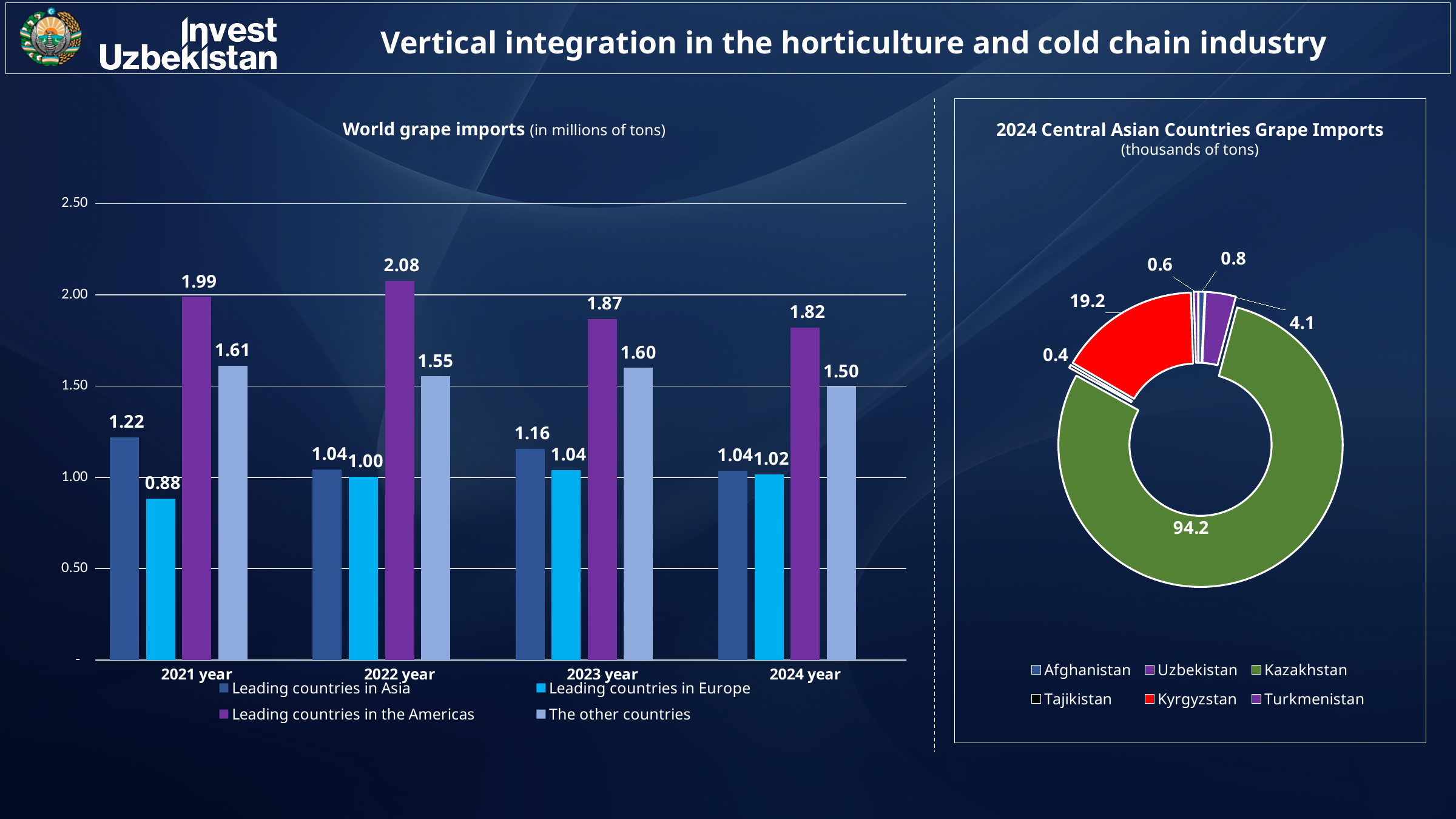
In the World grape imports chart, what is the value for Leading countries in Europe in 2021 year? 0.88 In the World grape imports chart, does the value for The other countries rise or fall from 2021 year to 2024 year? fall In the World grape imports chart, which year has the highest value for Leading countries in the Americas? 2022 year In the World grape imports chart, what is the value for The other countries in 2024 year? 1.50 In the World grape imports chart, what is the value for Leading countries in the Americas in 2022 year? 2.08 In the World grape imports chart, what is the difference between Leading countries in the Americas and The other countries in 2023 year? 0.27 In the World grape imports chart, how many series does the legend list? 4 In the World grape imports chart, which is larger in 2024 year: Leading countries in Asia or Leading countries in Europe? Leading countries in Asia In the 2024 Central Asian Countries Grape Imports chart, what is the value for Kazakhstan? 94.2 In the World grape imports chart, which series has the lowest value in 2021 year? Leading countries in Europe What kind of chart is the 2024 Central Asian Countries Grape Imports chart? Pie (doughnut) chart In the 2024 Central Asian Countries Grape Imports chart, what is the value for Kyrgyzstan? 19.2